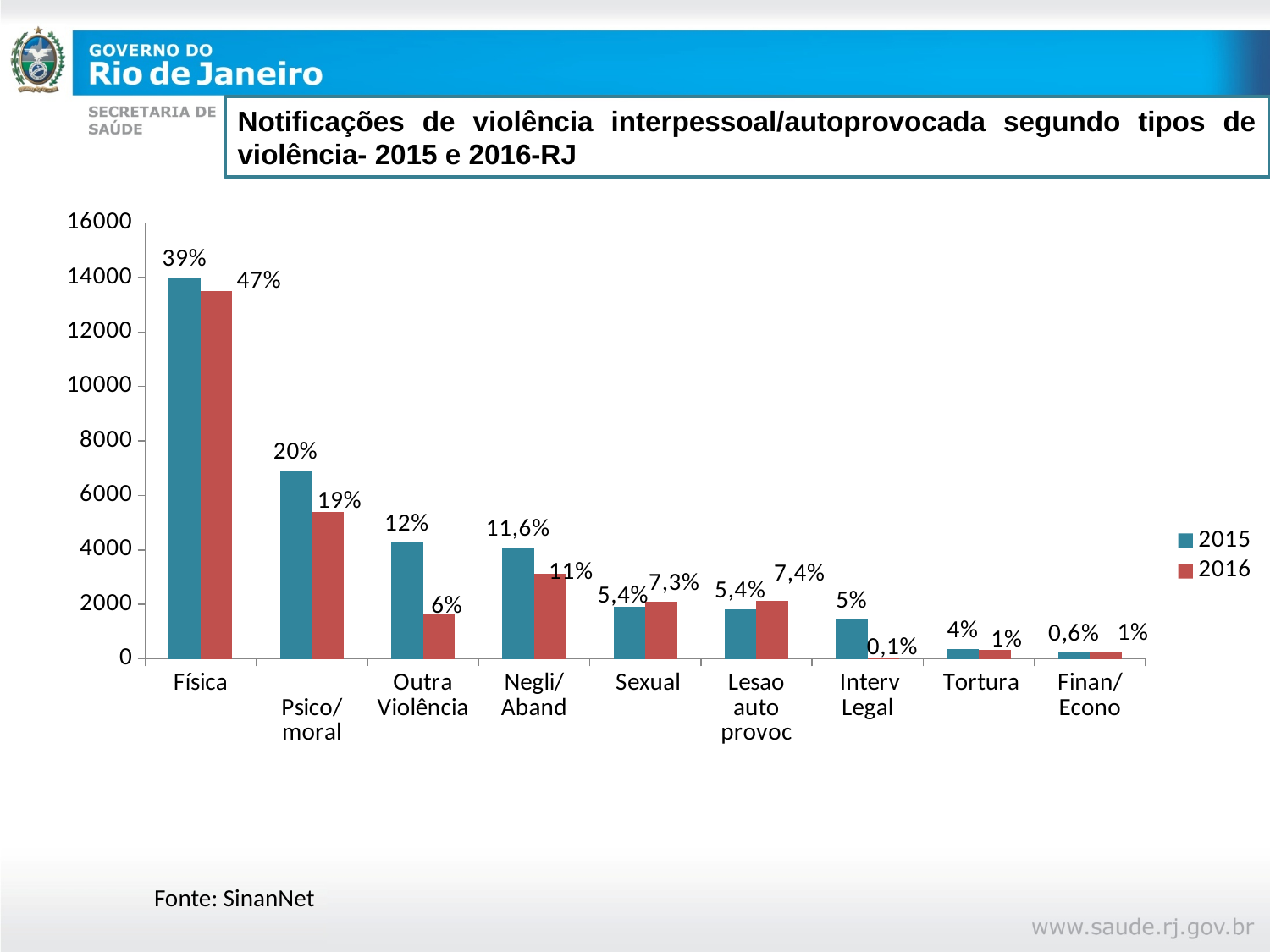
What percentage label is shown on the 2015 bar for Negli/Aband? 11,6% Which type of violence has the tallest bar for 2015? Física How many types of violence are shown on the x axis? 9 For Física, which bar is taller, 2015 or 2016? 2015 Is the 2016 bar for Outra Violência greater or less than 2000? less What percentage label is shown on the 2016 bar for Física? 47% Is the 2015 bar for Física greater or less than 12000? greater Which type of violence has the shortest bar for 2016? Interv Legal How many series does the legend list? 2 What percentage label is shown on the 2016 bar for Interv Legal? 0,1% What percentage label is shown on the 2016 bar for Outra Violência? 6% What percentage label is shown on the 2015 bar for Física? 39%